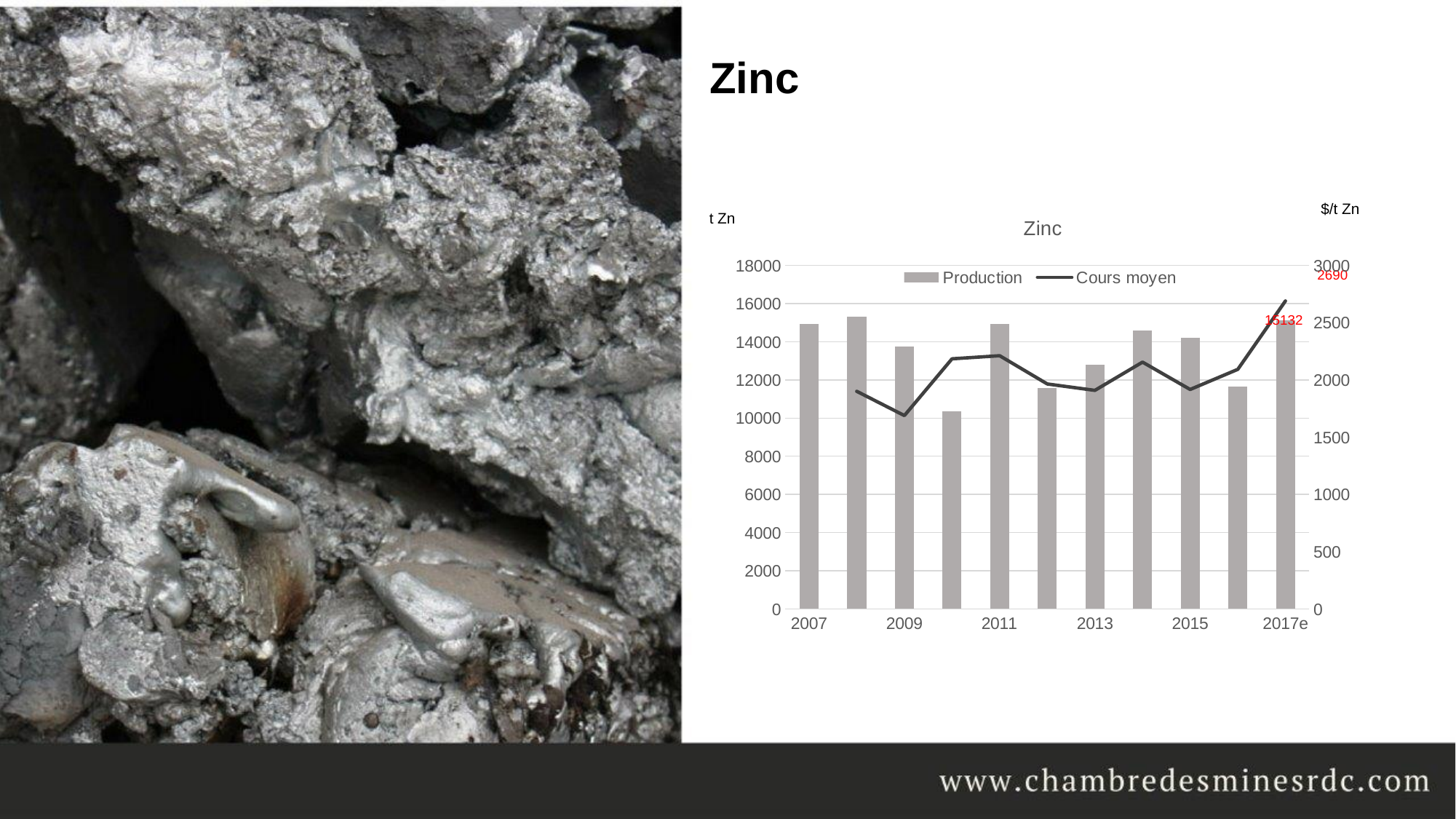
How many years (bars) are plotted on the x axis of the Zinc chart? 11 What kind of chart is shown on the slide? A combined bar and line chart Is the Production value for 2007 greater or less than 14000? greater Is the Production value for 2010 greater or less than 12000? less How many series does the legend of the Zinc chart list? 2 What is the Cours moyen value for 2017e? 2690 Does the Cours moyen line rise or fall from 2015 to 2017e? rise Which year has the highest Cours moyen value? 2017e Which year has the lowest Production bar? 2010 What is the Production value for 2017e? 15132 Which year has the lowest Cours moyen value? 2009 What are the two series named in the legend of the Zinc chart? Production and Cours moyen